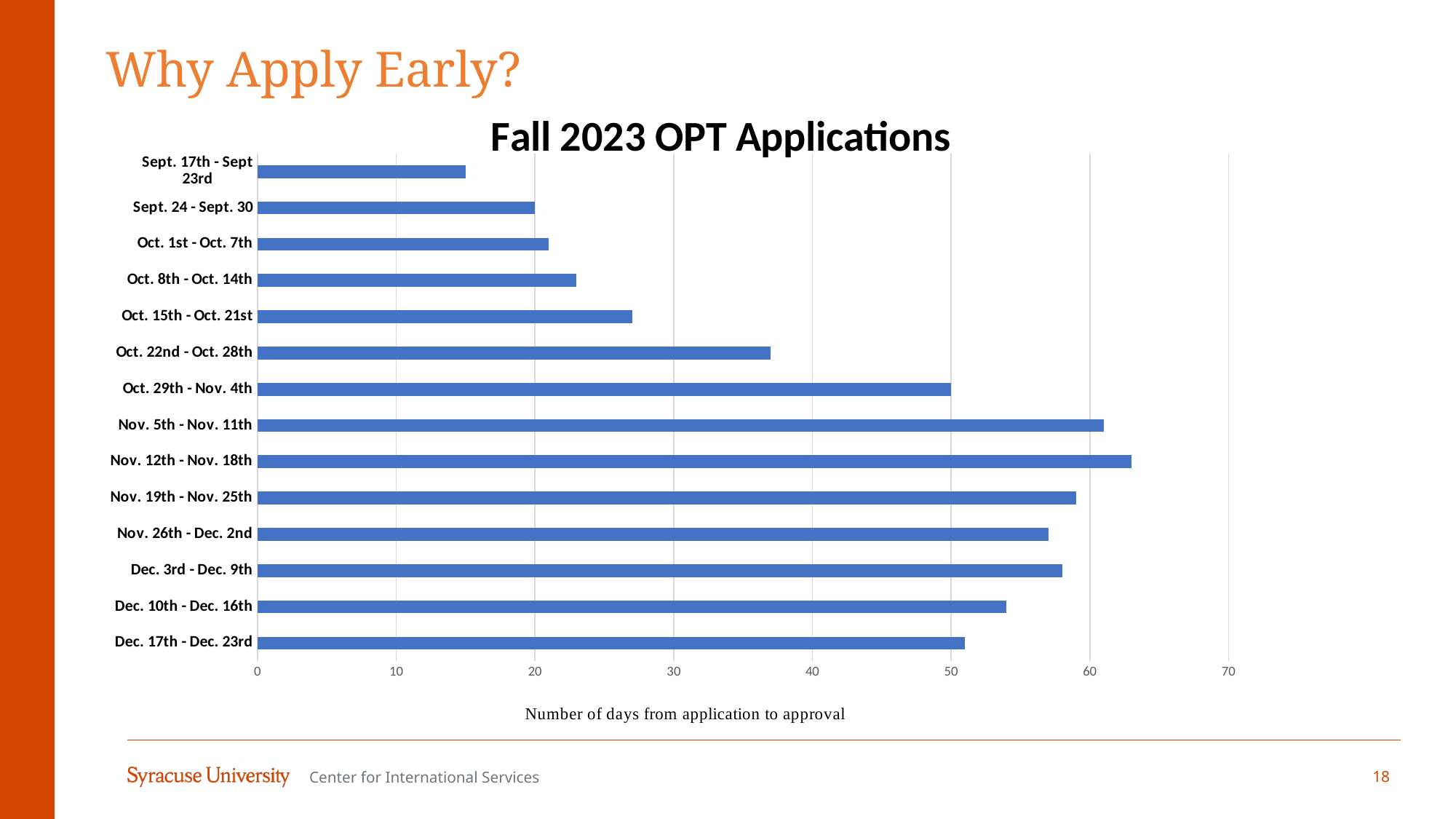
Is the value for Nov. 5th - Nov. 11th greater or less than 60? greater From Sept. 17th - Sept 23rd through Nov. 12th - Nov. 18th, do the values rise or fall? rise What is the number of days from application to approval for Oct. 29th - Nov. 4th? 50 Which date range has the highest number of days from application to approval? Nov. 12th - Nov. 18th What is the title of the chart? Fall 2023 OPT Applications What type of chart is shown on the slide? bar chart What does the horizontal axis of the chart measure, according to its label? Number of days from application to approval Is the value for Oct. 22nd - Oct. 28th greater or less than 40? less How many date-range categories are plotted in the chart? 14 Which has a larger value, Oct. 22nd - Oct. 28th or Oct. 15th - Oct. 21st? Oct. 22nd - Oct. 28th Which date range has the lowest number of days from application to approval? Sept. 17th - Sept 23rd Is the value for Oct. 15th - Oct. 21st greater or less than 30? less